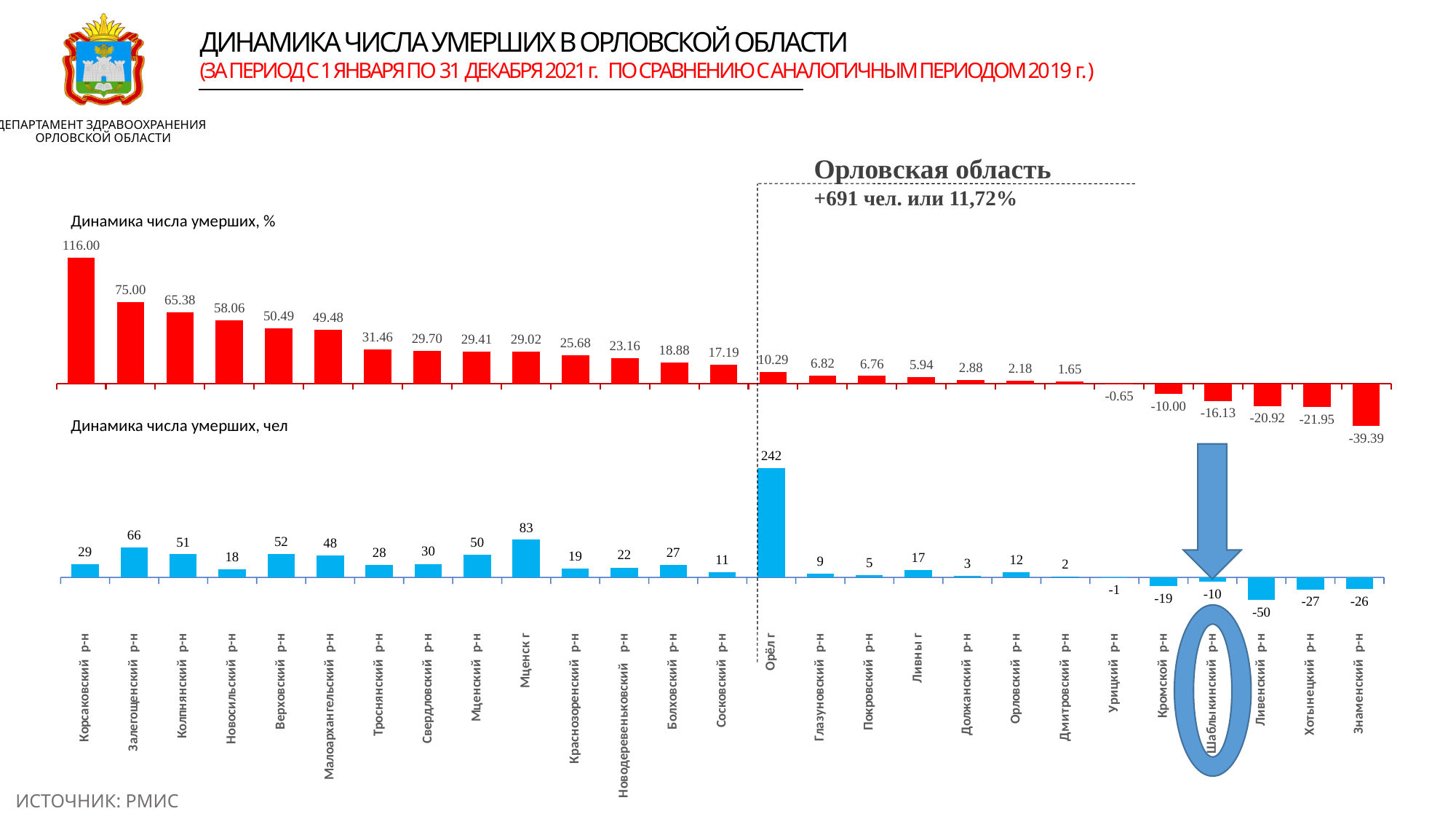
In the bottom chart 'Динамика числа умерших, чел', which category has the lowest value? Ливенский р-н How many categories are shown on the x axis of the bottom chart 'Динамика числа умерших, чел'? 27 In the bottom chart 'Динамика числа умерших, чел', what is the difference between the values for Мценск г and Залегощенский р-н? 17 In the bottom chart 'Динамика числа умерших, чел', which category has the highest value? Орёл г In the top chart 'Динамика числа умерших, %', which category has the lowest value? Знаменский р-н What type of chart is the top chart 'Динамика числа умерших, %'? bar chart In the bottom chart 'Динамика числа умерших, чел', which is larger: the value for Верховский р-н or Малоархангельский р-н? Верховский р-н In the top chart 'Динамика числа умерших, %', which is larger: the value for Троснянский р-н or Болховский р-н? Троснянский р-н In the bottom chart 'Динамика числа умерших, чел', what is the value for Орёл г? 242 In the top chart 'Динамика числа умерших, %', what is the value for Шаблыкинский р-н? -16.13 In the top chart 'Динамика числа умерших, %', what is the value for Корсаковский р-н? 116.00 In the top chart 'Динамика числа умерших, %', what is the difference between the values for Залегощенский р-н and Колпнянский р-н? 9.62